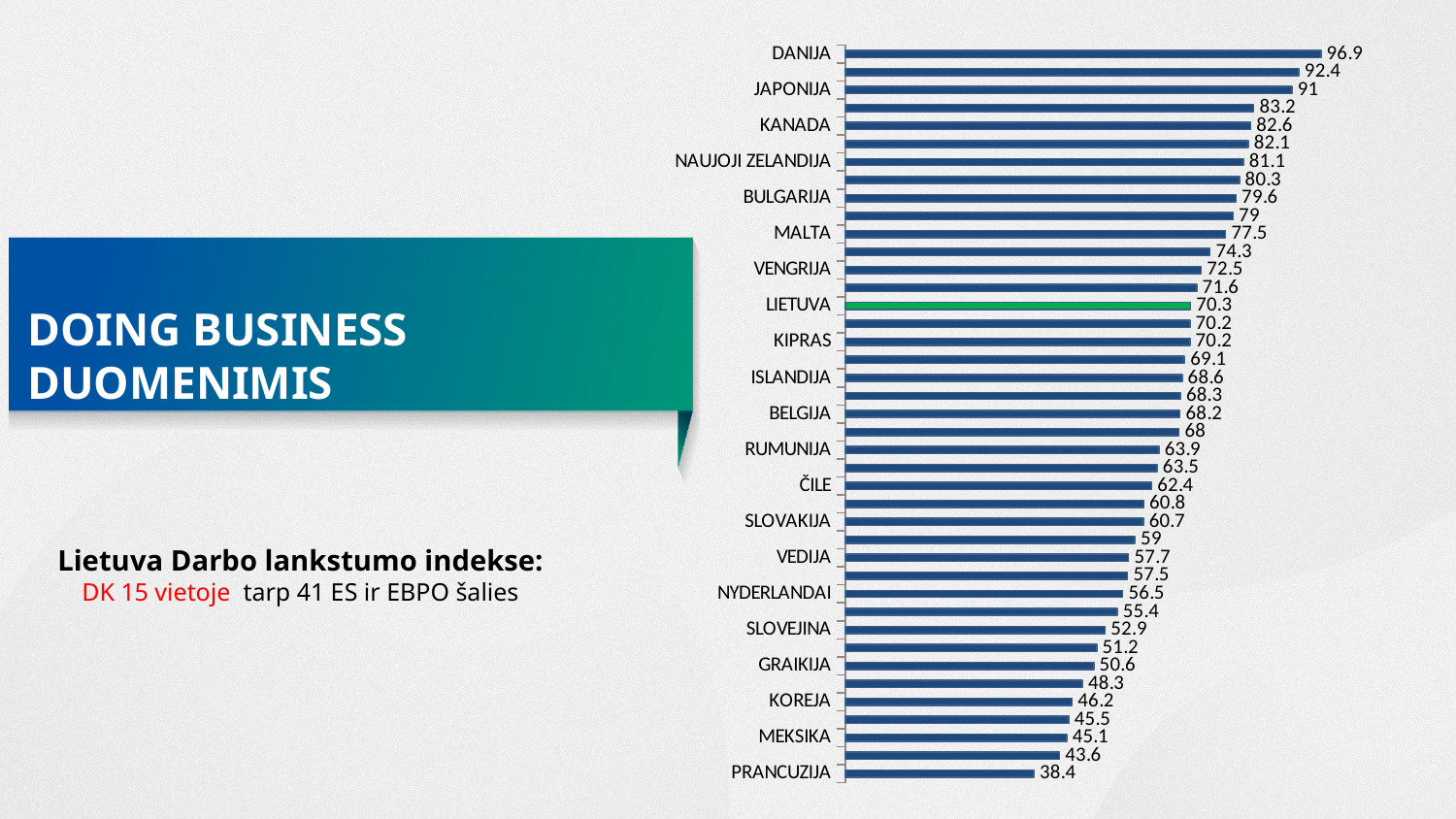
What is the difference between the values for LIETUVA and KIPRAS? 0.1 What is the difference between the values for DANIJA and PRANCUZIJA? 58.5 What is the value for DANIJA? 96.9 What kind of chart is shown on the slide? Bar chart What is the value for NYDERLANDAI? 56.5 Which has a larger value, KANADA or MALTA? KANADA What is the value for LIETUVA? 70.3 Which country's bar is highlighted in green? LIETUVA How many bars are plotted in the chart? 41 Which country has the highest value? DANIJA Which country has the lowest value? PRANCUZIJA What is the value for PRANCUZIJA? 38.4